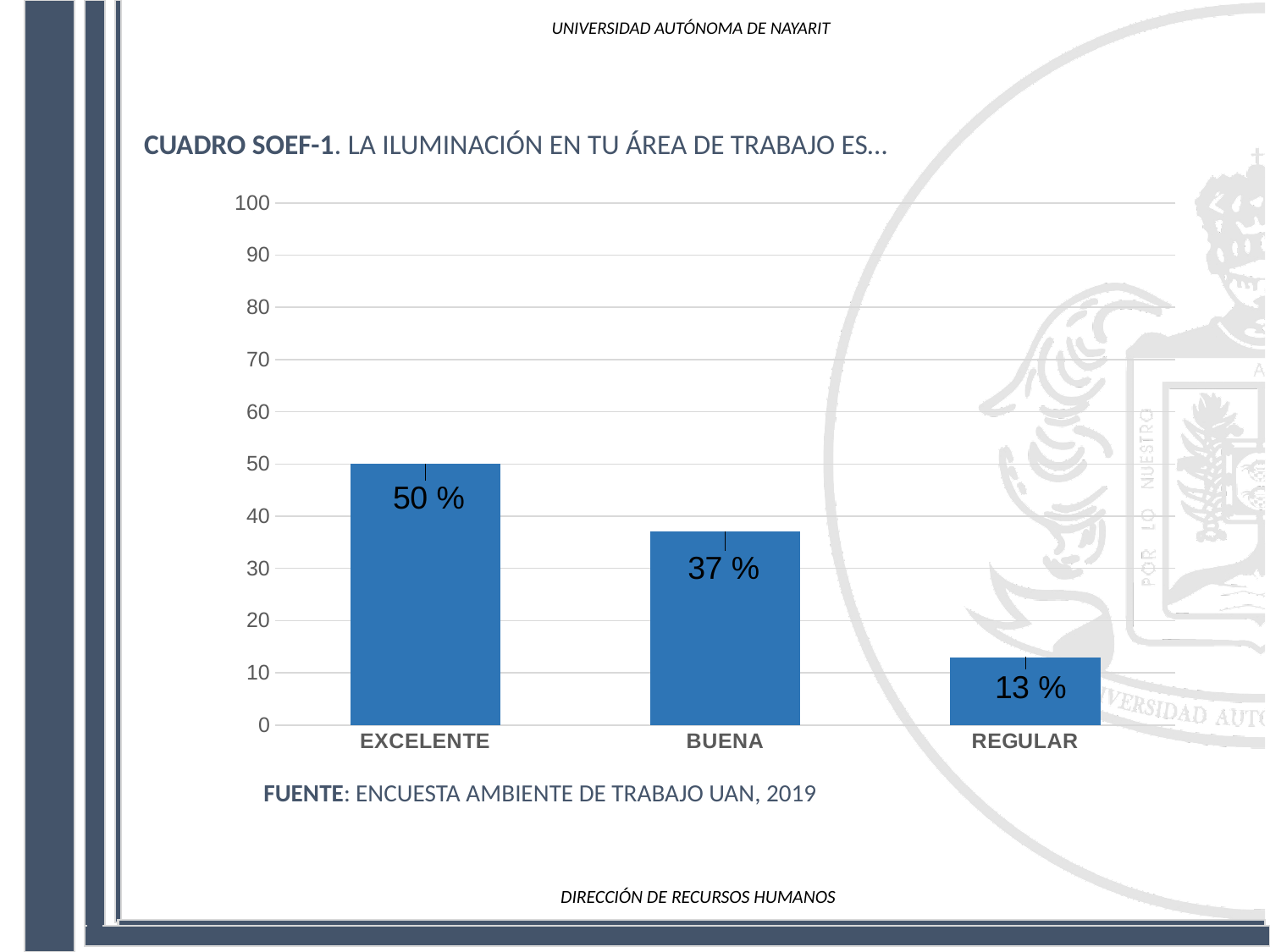
What is the value for BUENA? 37 % What kind of chart is shown on the slide? bar chart Which is larger, the value for BUENA or the value for REGULAR? BUENA Is the value for BUENA greater or less than 40? less How many categories are shown on the x axis? 3 What is the difference between the values for BUENA and REGULAR? 24 % Which category has the highest value? EXCELENTE What is the source cited below the chart? ENCUESTA AMBIENTE DE TRABAJO UAN, 2019 What is the difference between the values for EXCELENTE and BUENA? 13 % Which category has the lowest value? REGULAR What is the value for EXCELENTE? 50 % What is the value for REGULAR? 13 %